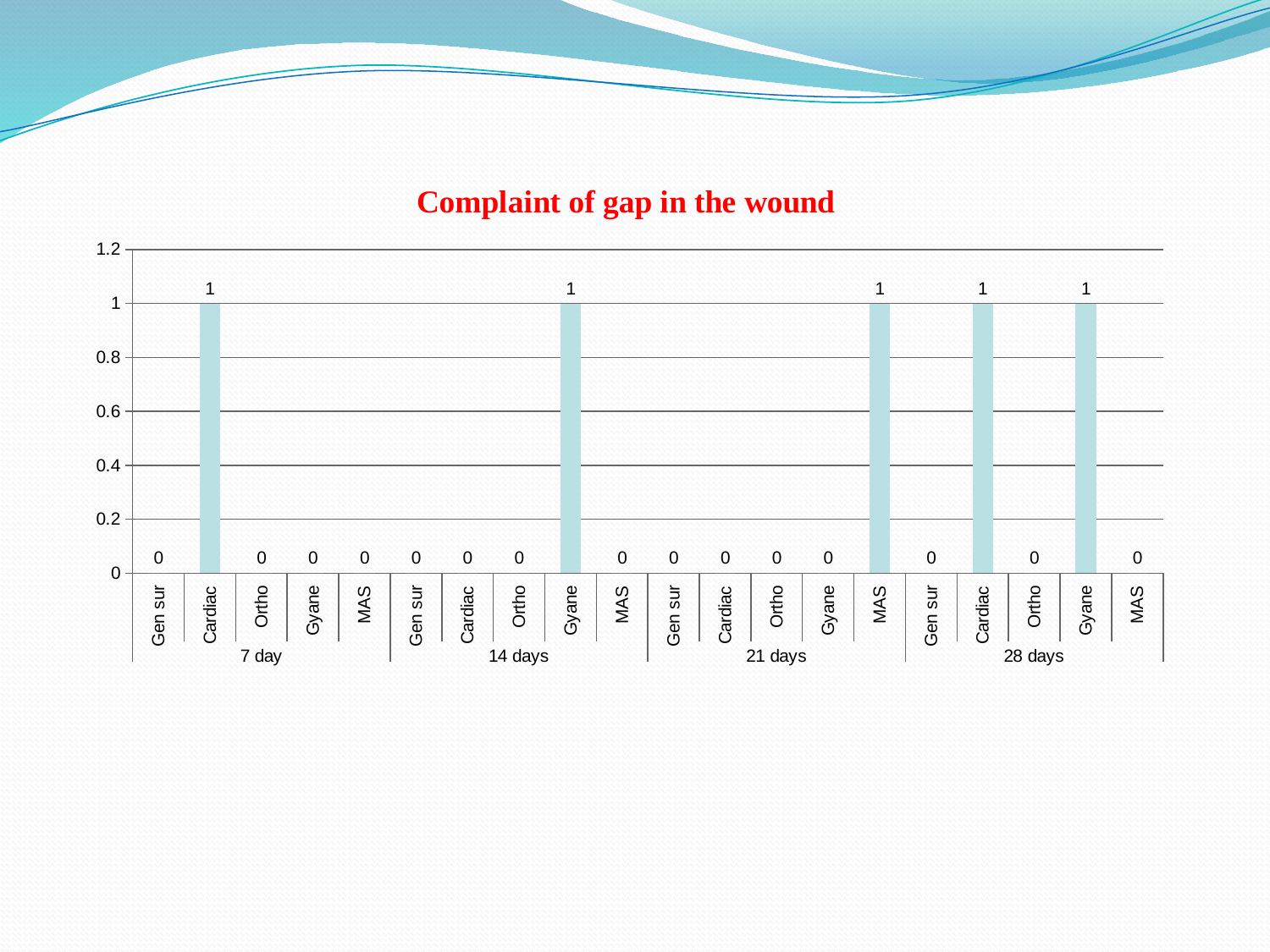
What is the value for Ortho in the 28 days group? 0 How many time-period groups are shown along the x axis? 4 Which is larger: the value for Gyane in the 14 days group or the value for Gyane in the 21 days group? Gyane in the 14 days group Which department has a value of 1 in the 21 days group? MAS What is the value for Gyane in the 14 days group? 1 How many bars in total have a value of 1? 5 What kind of chart is shown on the slide? Bar chart What is the title of the chart? Complaint of gap in the wound Which two departments have a value of 1 in the 28 days group? Cardiac and Gyane What is the value for Cardiac in the 7 day group? 1 What is the difference between the value for Cardiac and the value for Gen sur in the 7 day group? 1 What is the value for MAS in the 21 days group? 1